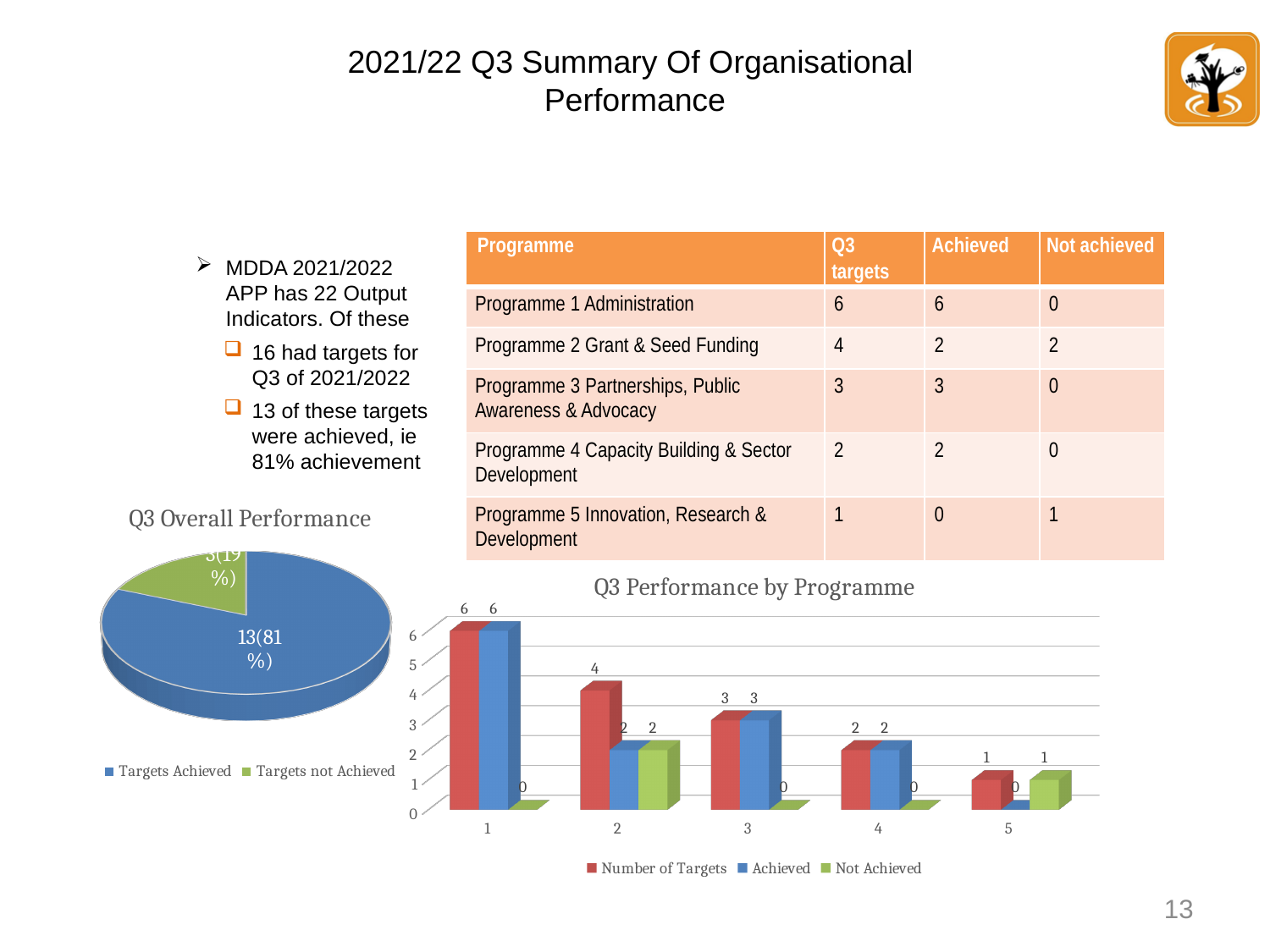
In the 'Q3 Performance by Programme' chart, which programme has the highest Number of Targets? 1 In the 'Q3 Performance by Programme' chart, what is the Not Achieved value for programme 5? 1 What kind of chart is 'Q3 Overall Performance'? pie chart In the 'Q3 Performance by Programme' chart, which programme has the lowest Number of Targets? 5 In the 'Q3 Performance by Programme' chart, is the Achieved value for programme 1 larger or smaller than the Achieved value for programme 4? larger How many series does the legend of the 'Q3 Performance by Programme' chart list? 3 How many programme categories are shown on the x axis of the 'Q3 Performance by Programme' chart? 5 In the 'Q3 Performance by Programme' chart, what is the difference between the Number of Targets and the Achieved value for programme 2? 2 In the 'Q3 Performance by Programme' chart, what is the Achieved value for programme 3? 3 What kind of chart is 'Q3 Performance by Programme'? bar chart In the 'Q3 Overall Performance' pie chart, what share of the pie is Targets Achieved? 81% In the 'Q3 Performance by Programme' chart, what is the Number of Targets for programme 2? 4